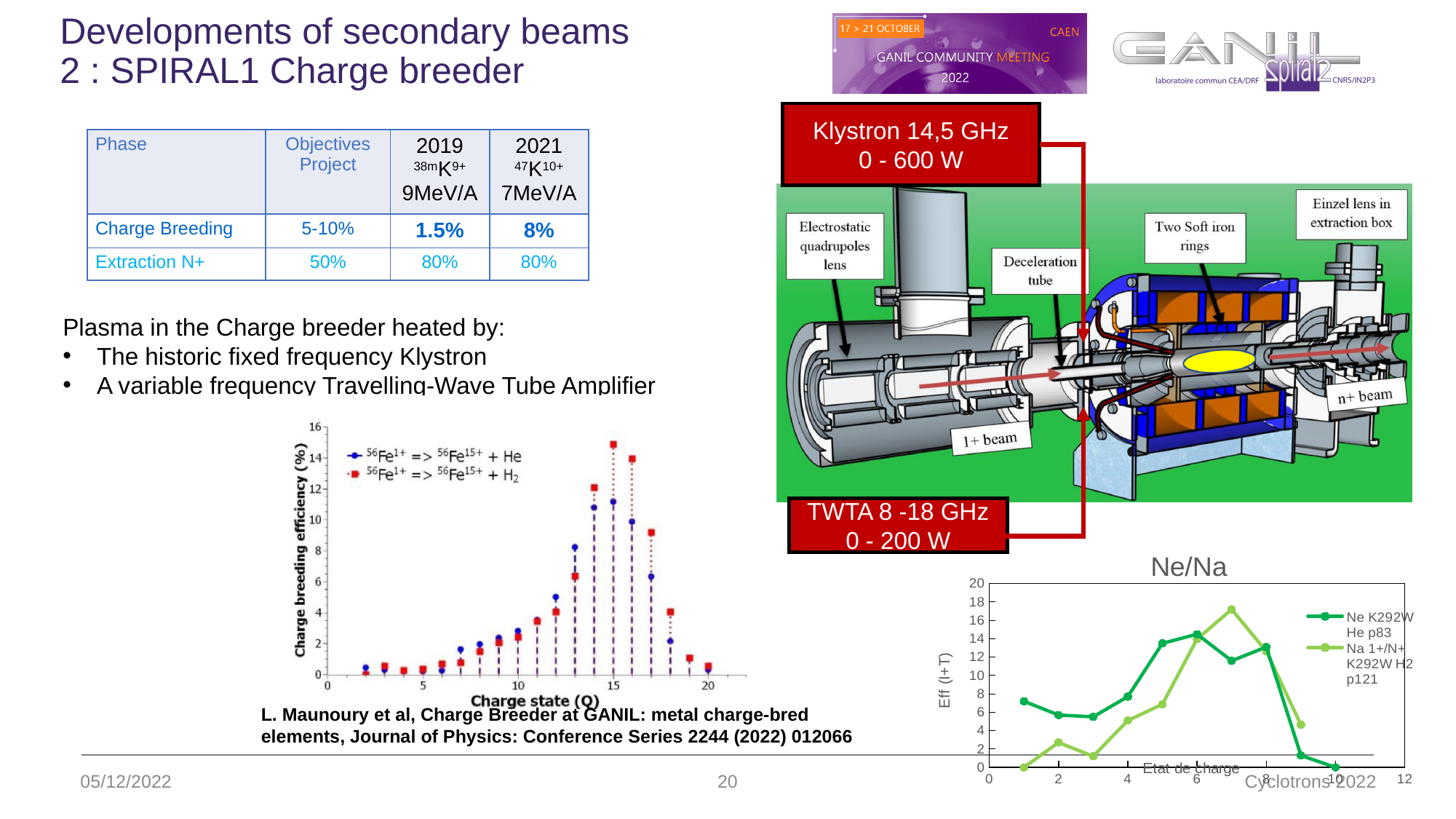
In the Ne/Na chart, which series has the larger value at charge state 7? Na 1+/N+ K292W H2 p121 In the Ne/Na chart, at which charge state does the Ne K292W He p83 series reach its highest value? 6 In the Ne/Na chart, what is the label of the y axis? Eff (I+T) In the Ne/Na chart, at which charge state does the Na 1+/N+ K292W H2 p121 series reach its highest value? 7 In the Ne/Na chart, is the value of the Na 1+/N+ K292W H2 p121 series at charge state 7 greater or less than 16? greater In the Ne/Na chart, which series has the larger value at charge state 2? Ne K292W He p83 In the charge breeding efficiency chart for 56Fe, is the H2 series value at charge state 15 greater or less than 12? greater How many series does the legend of the Ne/Na chart list? 2 In the charge breeding efficiency chart for 56Fe, at which charge state does the H2 series reach its highest efficiency? 15 What kind of chart is the Ne/Na chart at the bottom right of the slide? line chart In the Ne/Na chart, is the value of the Ne K292W He p83 series at charge state 10 greater or less than 2? less In the charge breeding efficiency chart for 56Fe, how many series does the legend list? 2